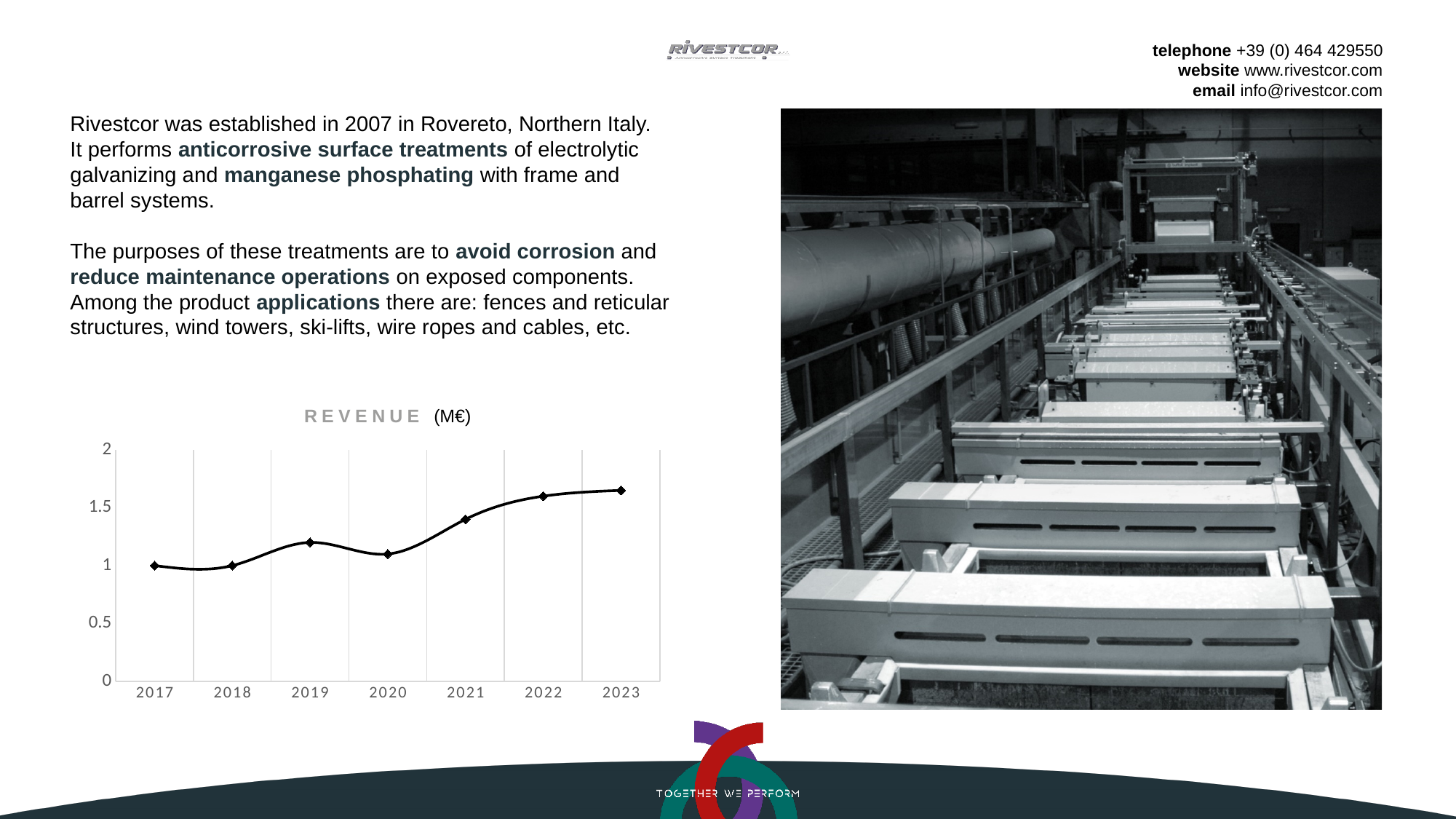
Is the revenue value for 2023 greater or less than 1.5? greater What unit is shown next to the REVENUE chart title? M€ How many years are shown on the x axis of the REVENUE chart? 7 What kind of chart is the REVENUE chart? line chart Which year has the higher revenue, 2021 or 2018? 2021 Is the revenue value for 2022 greater or less than 1.5? greater Which year has the higher revenue, 2019 or 2020? 2019 Is the revenue value for 2021 greater or less than 1? greater Does revenue generally rise or fall from 2017 to 2023? rise What is the first year shown on the REVENUE chart? 2017